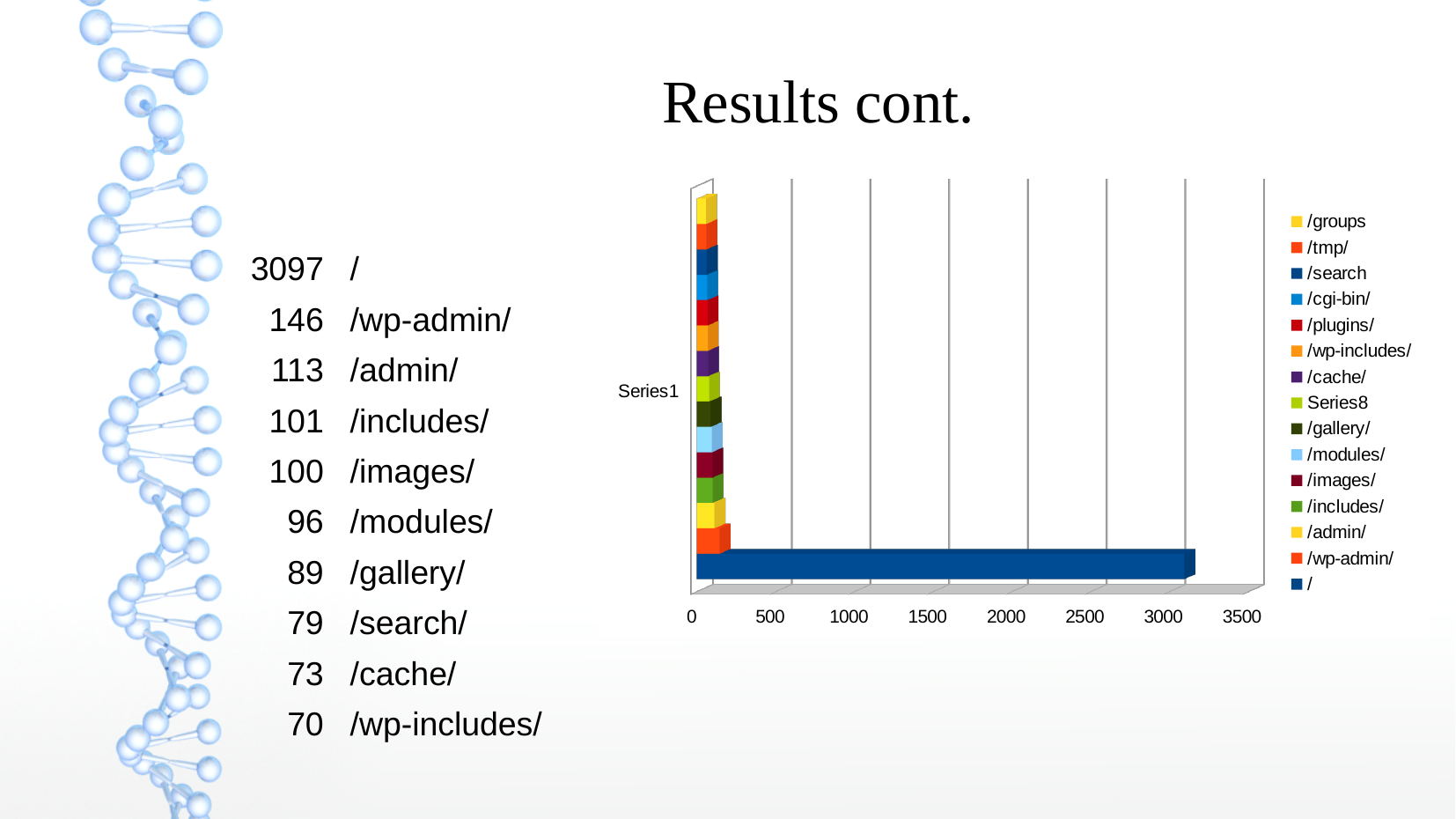
How many series does the chart's legend list? 15 According to the values listed on the slide, what is the count for "/wp-admin/"? 146 Which is larger, the bar for "/" or the bar for "/wp-admin/"? / What kind of chart is shown on the slide? bar chart How many categories are shown on the chart's category axis? 1 What is the label of the single category on the chart's vertical axis? Series1 Is the value for the "/wp-admin/" series greater or less than 500? less Which series has the longest bar in the chart? / Which legend entry is not a directory path? Series8 According to the values listed on the slide, what is the count for "/"? 3097 Using the values listed on the slide, what is the difference between the counts for "/" and "/wp-admin/"? 2951 Is the value for the "/" series greater or less than 2500? greater